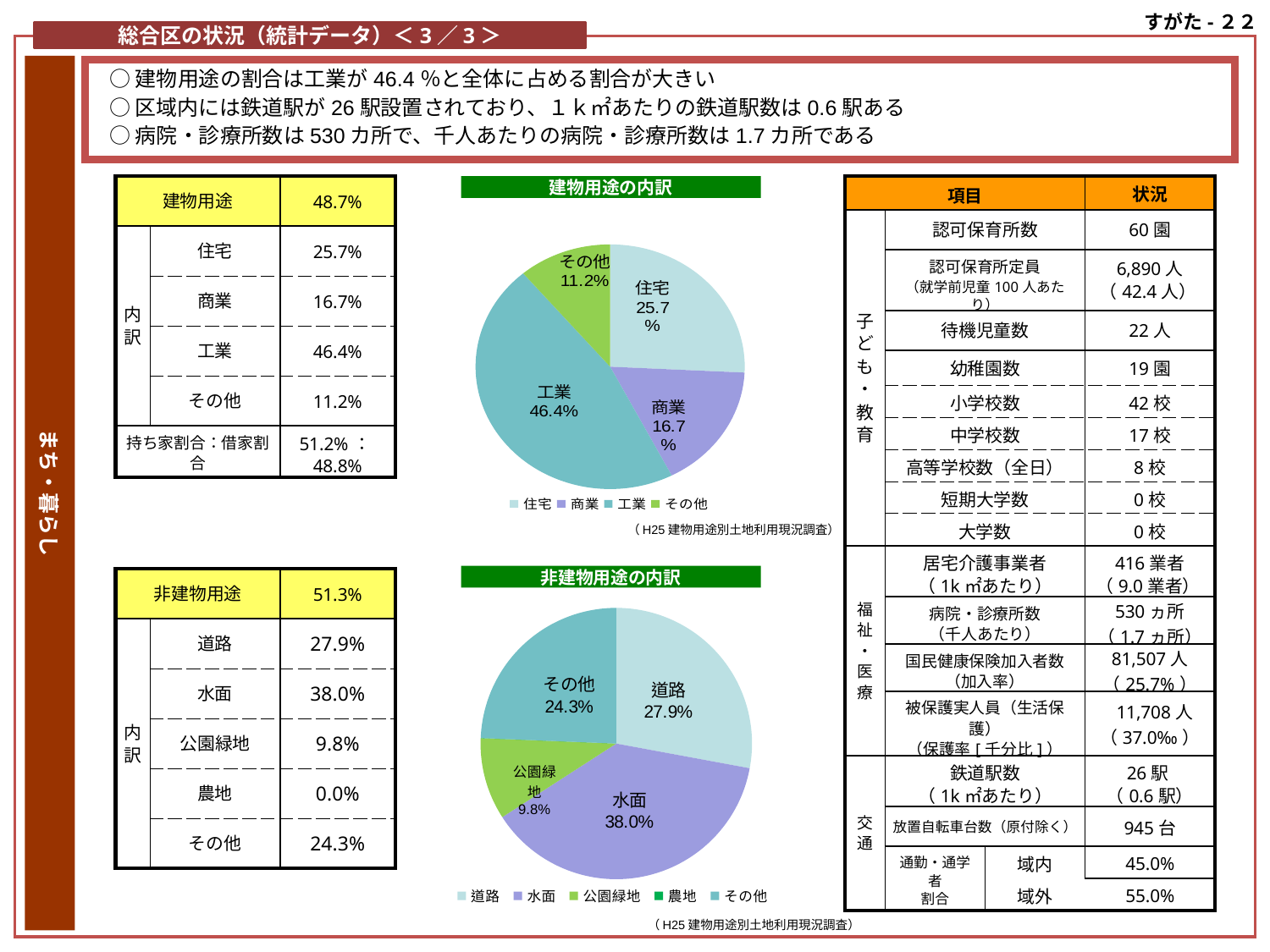
In the 建物用途の内訳 pie chart, what is the difference between the shares of 工業 and 住宅? 20.7% What type of chart is the 非建物用途の内訳 chart? pie chart In the 非建物用途の内訳 pie chart, what is the share for 公園緑地? 9.8% In the 非建物用途の内訳 pie chart, how many categories does the legend list? 5 In the 建物用途の内訳 pie chart, how many categories does the legend list? 4 In the 建物用途の内訳 pie chart, which category has the smallest share? その他 In the 非建物用途の内訳 pie chart, what is the share for 水面? 38.0% In the 建物用途の内訳 pie chart, what is the share for 工業? 46.4% In the 非建物用途の内訳 pie chart, which category has the largest share? 水面 In the 建物用途の内訳 pie chart, what is the share for 商業? 16.7% In the 建物用途の内訳 pie chart, which category has the largest share? 工業 In the 非建物用途の内訳 pie chart, which is larger, 道路 or その他? 道路